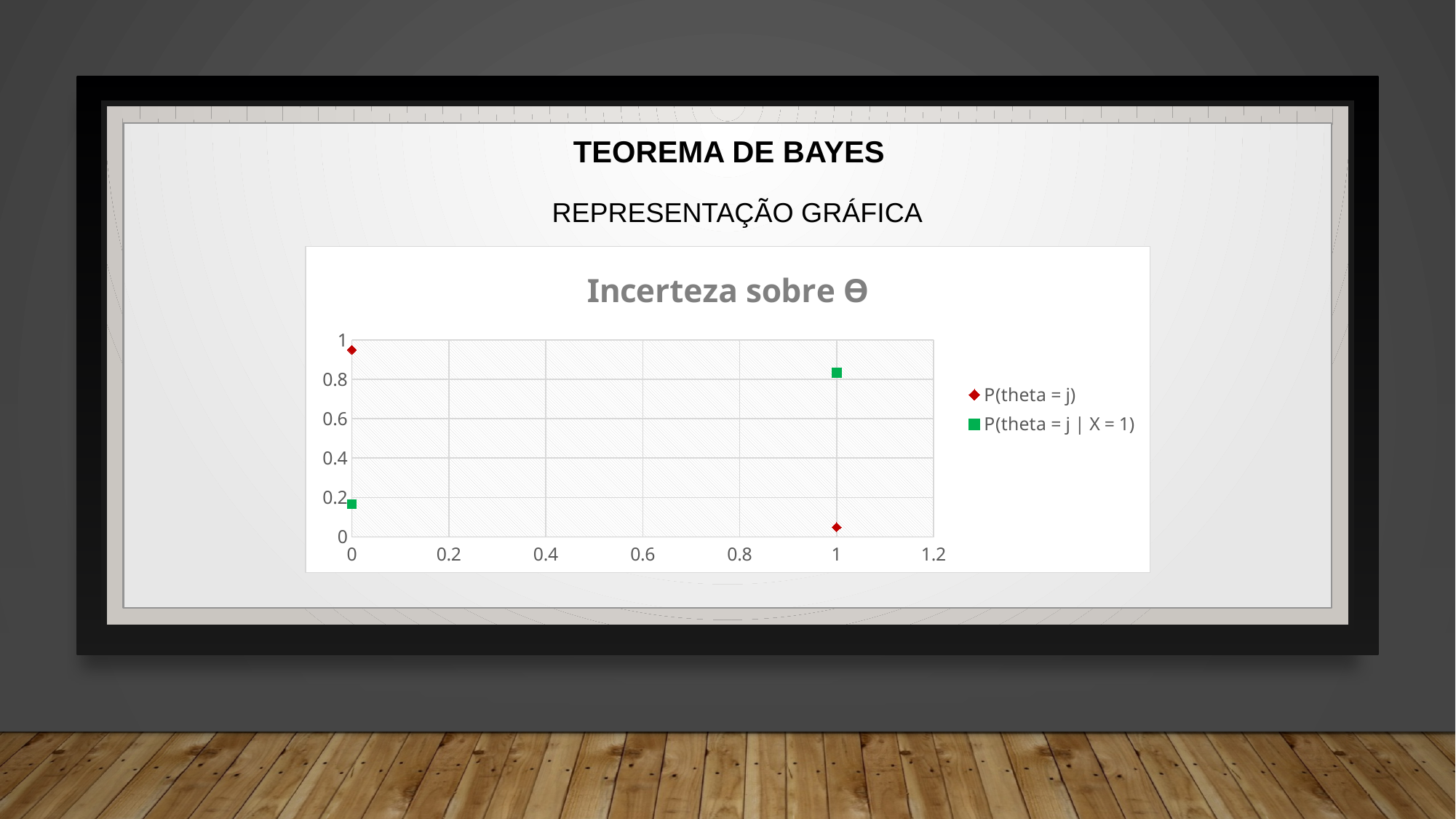
What kind of chart is shown on the slide? scatter chart Is the value of P(theta = j | X = 1) at x = 1 greater or less than 0.6? greater Do the values of the P(theta = j) series rise or fall from x = 0 to x = 1? fall How many points are plotted for the P(theta = j | X = 1) series? 2 Is the value of P(theta = j | X = 1) at x = 0 greater or less than 0.4? less Which series is drawn with green square markers? P(theta = j | X = 1) What is the title of the chart? Incerteza sobre Θ At x = 0, which series has the larger value, P(theta = j) or P(theta = j | X = 1)? P(theta = j) At x = 1, which series has the larger value, P(theta = j) or P(theta = j | X = 1)? P(theta = j | X = 1) Is the value of P(theta = j) at x = 1 greater or less than 0.2? less How many series does the chart legend list? 2